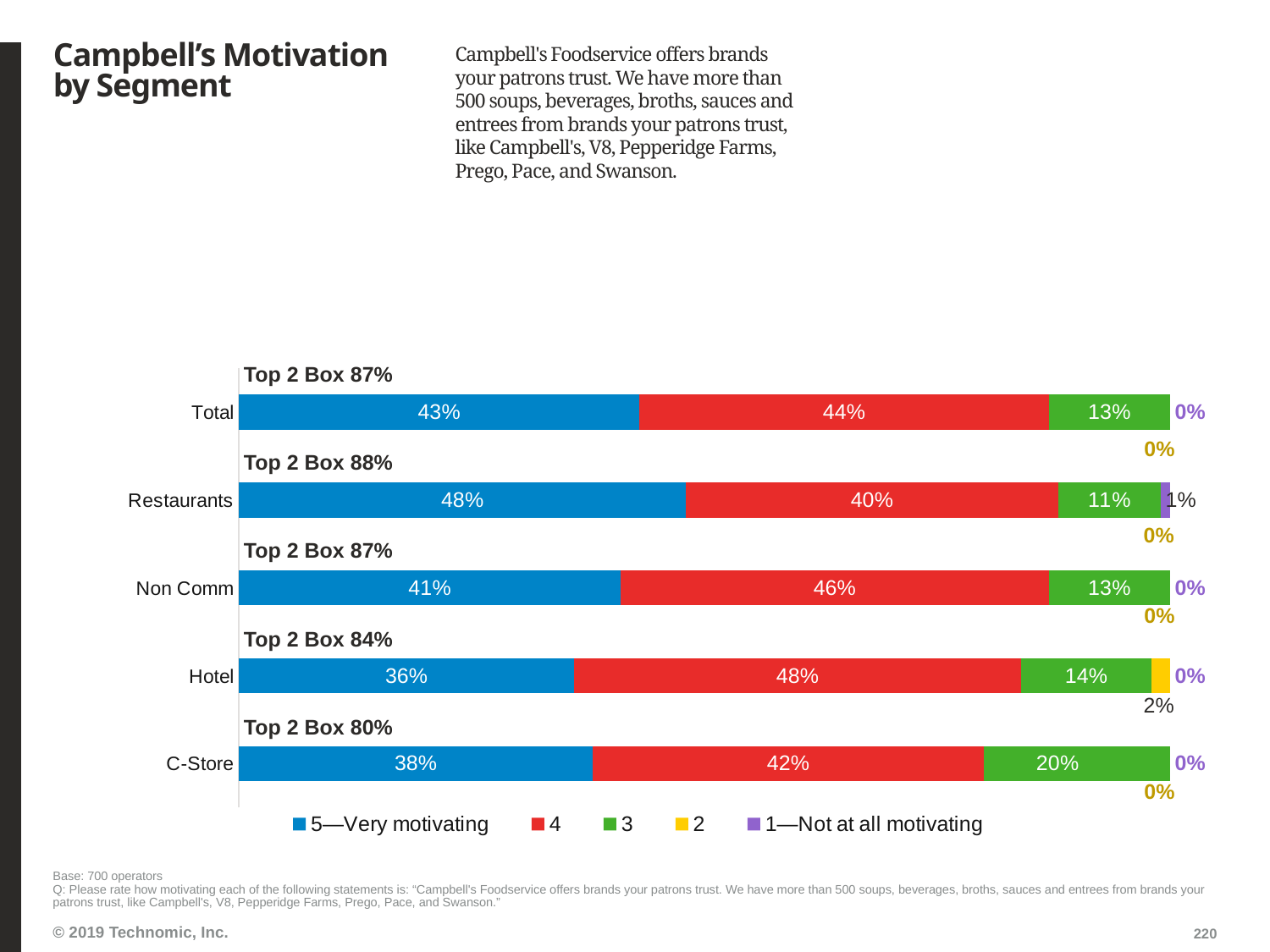
What is the combined value of the "5—Very motivating" and "4" segments for C-Store? 80% What is the Top 2 Box value for Hotel? 84% Which is larger: the "5—Very motivating" value for Non Comm or for Hotel? Non Comm What is the difference between the "4" value for Hotel and the "4" value for Restaurants? 8% How many segments (categories) are plotted on the chart? 5 Which segment has the highest "5—Very motivating" value? Restaurants How many series does the legend list? 5 What is the "3" value for C-Store? 20% Which legend entry is shown in red? 4 What is the "5—Very motivating" value for Restaurants? 48% Which segment has the lowest Top 2 Box value? C-Store What kind of chart is shown on the slide? Stacked bar chart